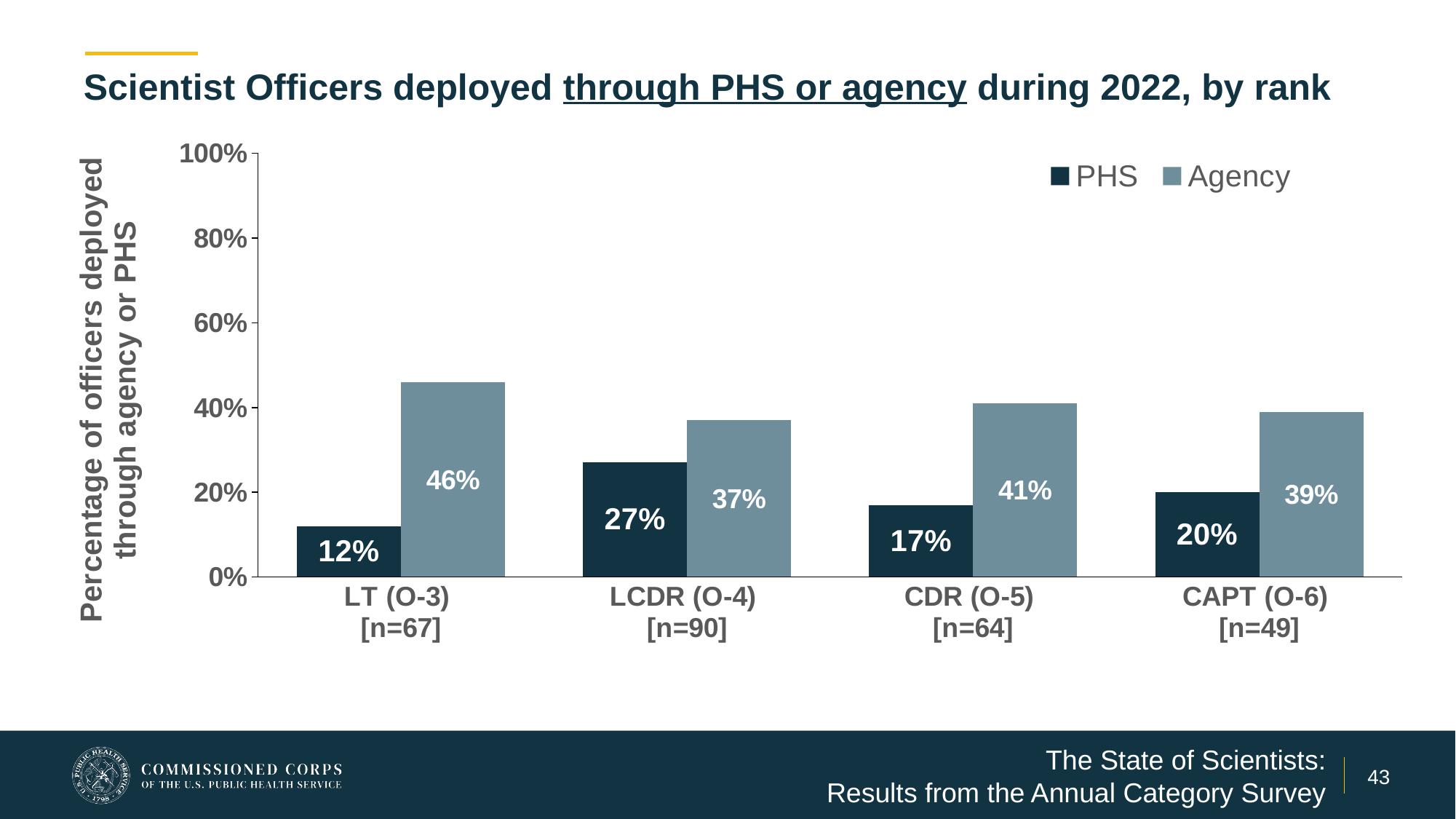
Which is larger for CAPT (O-6): the PHS percentage or the Agency percentage? Agency Which rank has the lowest percentage of officers deployed through their agency? LCDR (O-4) What is the sample size (n) for the LCDR (O-4) rank? 90 Which rank has the highest percentage of officers deployed through PHS? LCDR (O-4) How many rank categories are shown on the x axis? 4 Is the Agency value for LT (O-3) greater or less than 40%? greater What percentage of CDR (O-5) officers were deployed through their agency? 41% What kind of chart is shown on the slide? Bar chart What percentage of CAPT (O-6) officers were deployed through PHS? 20% What percentage of LT (O-3) officers were deployed through PHS? 12% How many series does the legend list? 2 What is the difference between the Agency and PHS percentages for LT (O-3)? 34 percentage points